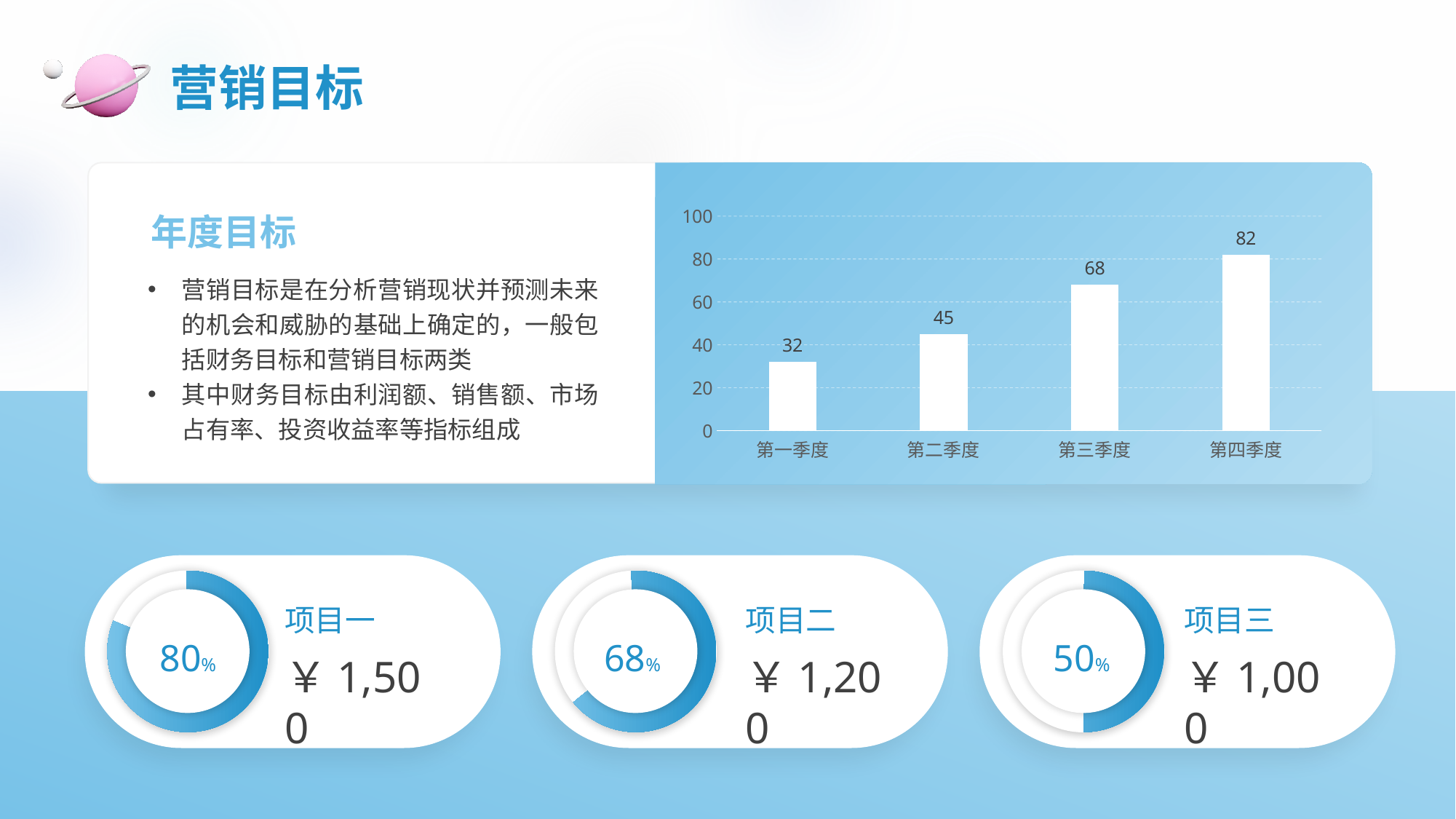
In the bar chart at the top right, which quarter has the lowest value? 第一季度 In the bar chart at the top right, what is the difference between the values for 第四季度 and 第二季度? 37 What kind of chart is shown at the top right of the slide? bar chart In the bar chart at the top right, is the value for 第四季度 greater or less than 60? greater In the bar chart at the top right, do the values rise or fall from 第一季度 to 第四季度? rise In the bar chart at the top right, which is larger, the value for 第二季度 or 第三季度? 第三季度 In the bar chart at the top right, which quarter has the highest value? 第四季度 In the ring chart for 项目二 at the bottom of the slide, what percentage is shown? 68% In the bar chart at the top right, what is the value for 第三季度? 68 Among the three ring charts at the bottom of the slide, which project shows the lowest percentage? 项目三 In the bar chart at the top right, what is the value for 第一季度? 32 How many categories are shown in the bar chart at the top right? 4